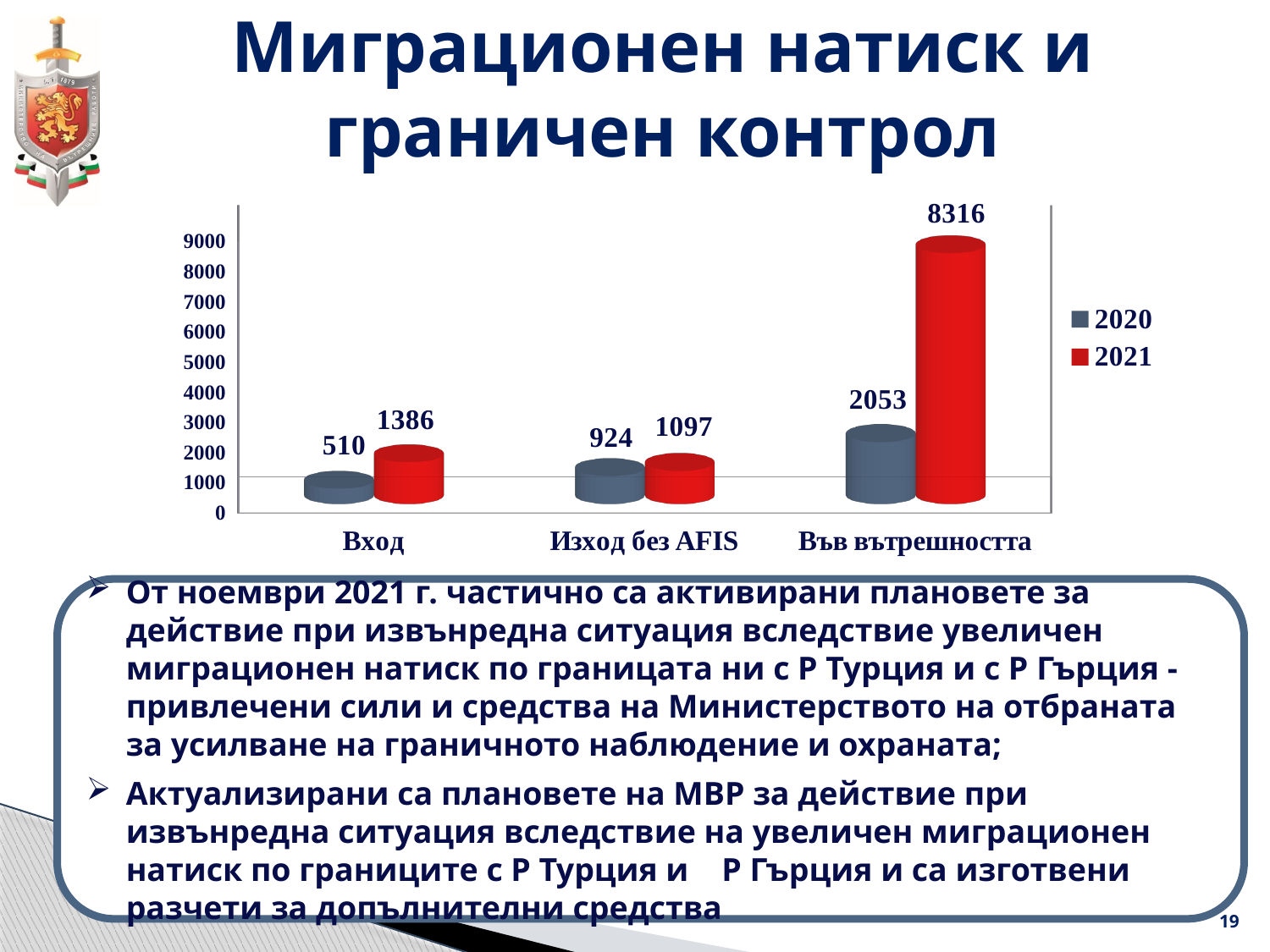
What kind of chart is shown on the slide? Bar chart Which is larger in the "Изход без AFIS" category, the 2020 value or the 2021 value? 2021 What is the value for 2021 in the "Изход без AFIS" category? 1097 What is the difference between the 2021 and 2020 values in the "Във вътрешността" category? 6263 Which category has the lowest value for the 2020 series? Вход What is the value for 2020 in the "Вход" category? 510 How many categories are shown on the x axis of the chart? 3 How many series does the chart's legend list? 2 Which category has the highest value for the 2021 series? Във вътрешността What is the difference between the 2021 and 2020 values in the "Вход" category? 876 What is the value for 2021 in the "Във вътрешността" category? 8316 What is the value for 2020 in the "Във вътрешността" category? 2053